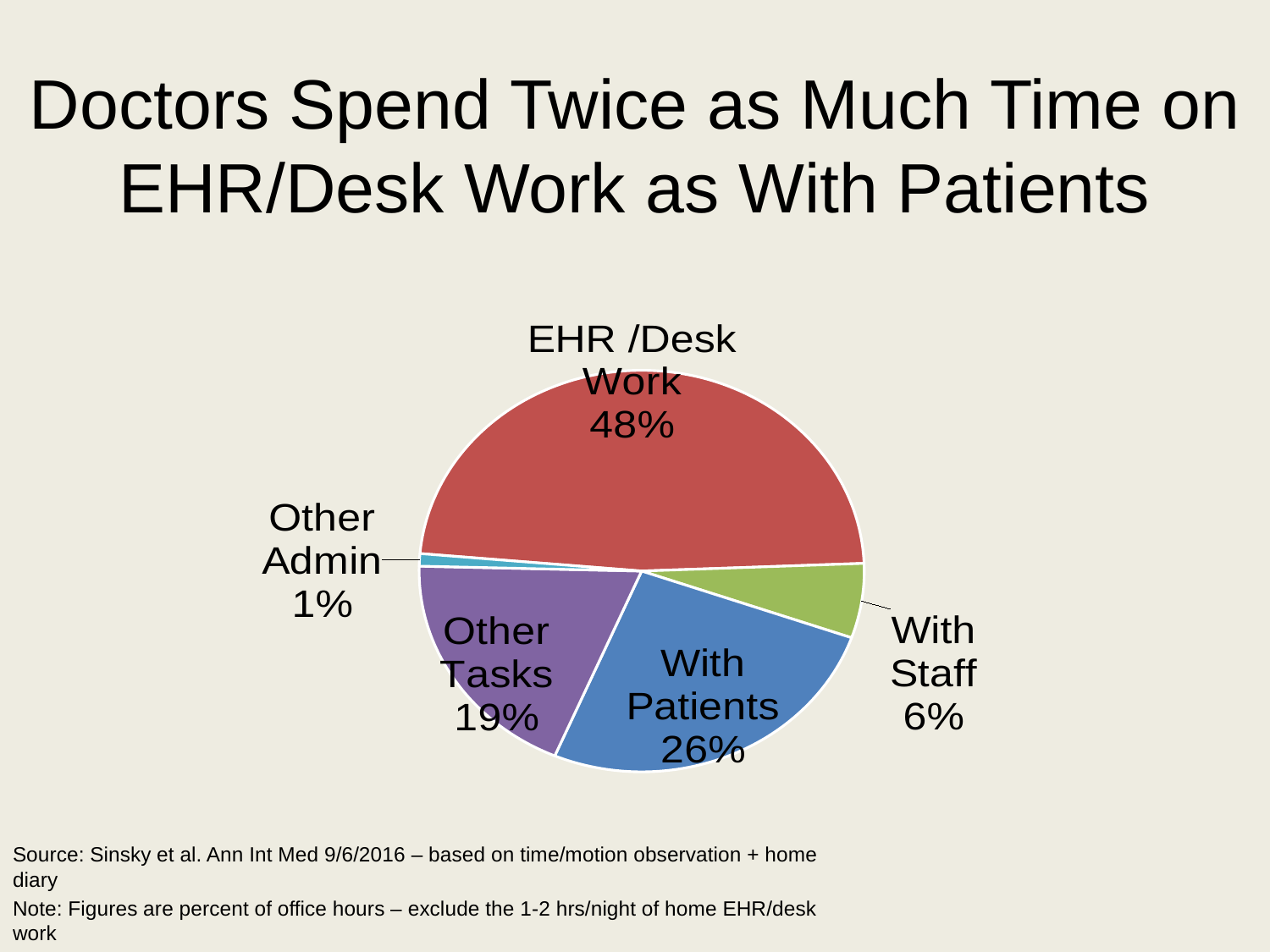
What percentage is shown for Other Admin? 1% What kind of chart is shown on the slide? pie chart Which is larger, the share for Other Tasks or the share for With Staff? Other Tasks What percentage of office hours do doctors spend on EHR/Desk Work? 48% Which category takes the smallest share of the pie? Other Admin How many slices does the pie chart have? 5 What is the difference in percentage points between EHR/Desk Work and With Patients? 22 What share of the pie is labelled Other Tasks? 19% What percentage of office hours is spent With Patients? 26% What colour is the EHR/Desk Work slice? red What percentage is shown for With Staff? 6% Which category takes the largest share of the pie? EHR/Desk Work